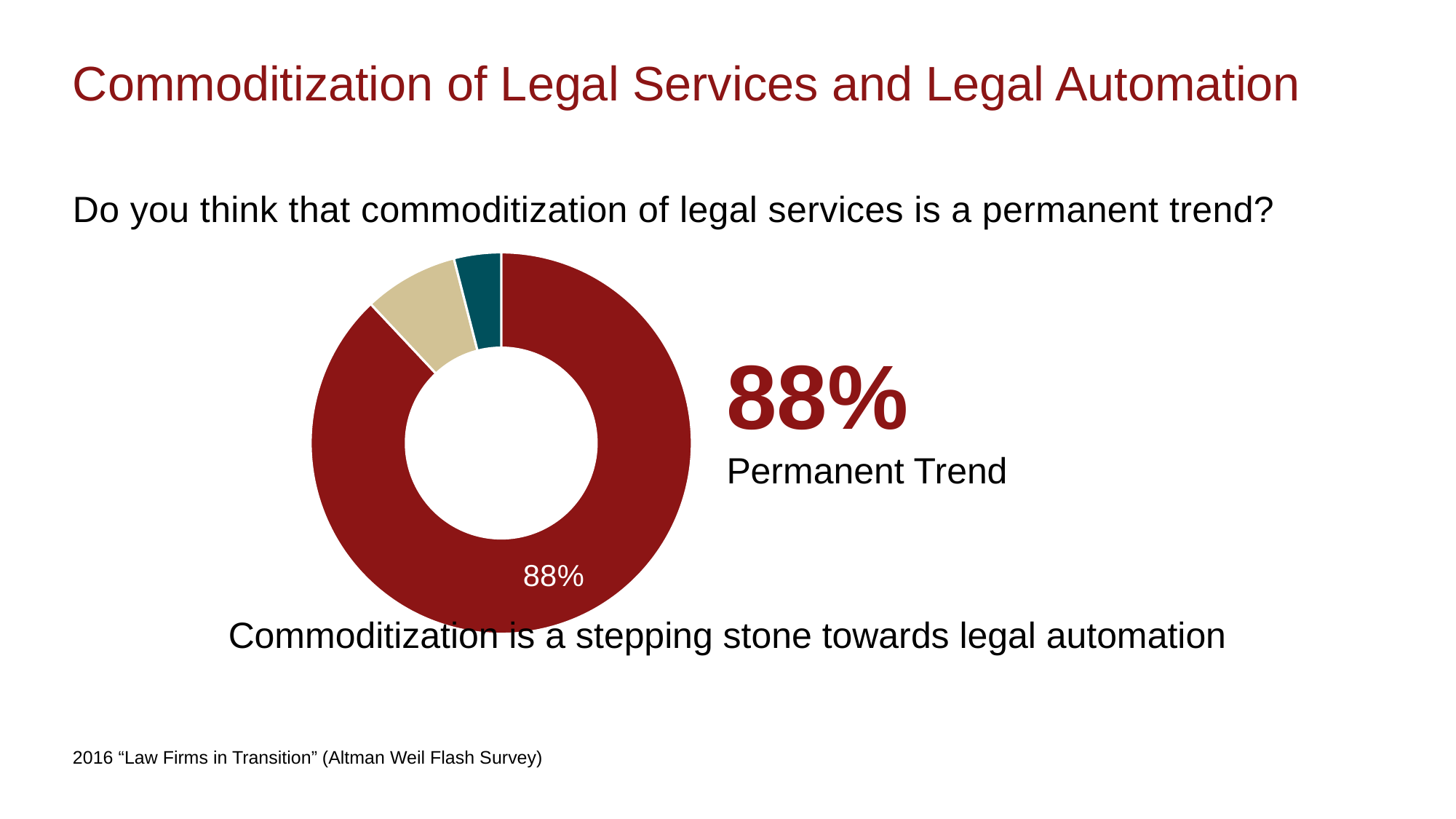
How many slices does the doughnut chart have? 3 Which is larger, the tan slice or the teal slice? the tan slice What percentage is shown for the Permanent Trend slice? 88% Which slice of the doughnut chart is the smallest? the teal slice What share of the doughnut chart does the largest slice represent? 88% What survey question does the chart answer? Do you think that commoditization of legal services is a permanent trend? Is the Permanent Trend slice greater or less than 50% of the chart? greater What kind of chart is shown on the slide? doughnut chart Which slice of the doughnut chart is the largest? Permanent Trend (88%) What colour is the largest slice of the doughnut chart? dark red